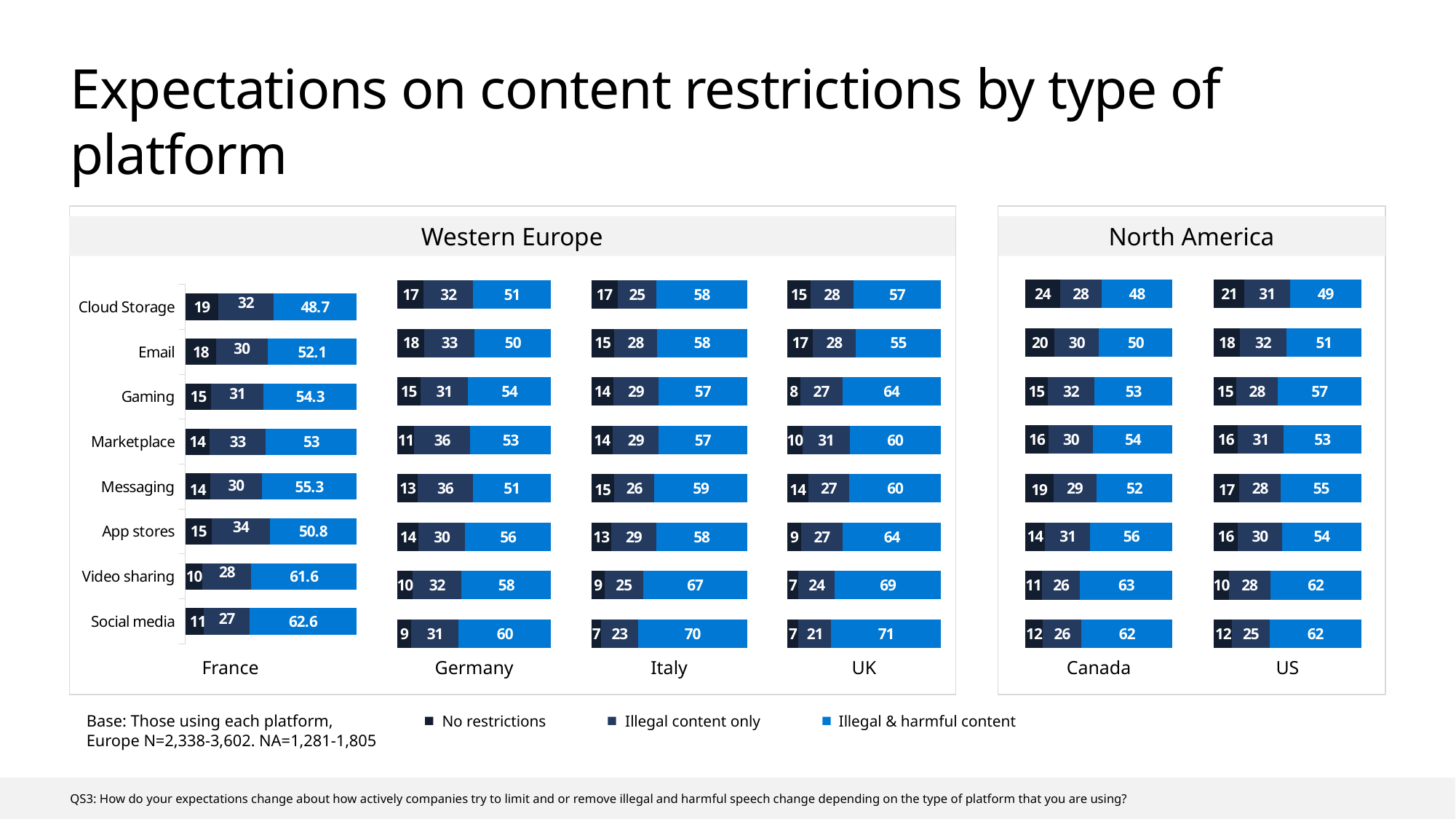
In the Germany chart, which platform has the lowest value for "No restrictions"? Social media How many platform categories are shown in the France chart? 8 Which two countries are shown under the North America heading? Canada and US In the Canada chart, what is the value for "No restrictions" for Cloud Storage? 24 In the France chart, what is the value for "Illegal & harmful content" for Social media? 62.6 In the Canada chart, what is the total of the Video sharing bar? 100 In the Italy chart, which platform has the highest value for "Illegal & harmful content"? Social media In the UK chart, what is the difference between the "Illegal & harmful content" values for Social media and Cloud Storage? 14 What kind of chart is used for each country? Stacked bar chart For Marketplace, is the "Illegal content only" value larger in the Germany chart or the Italy chart? Germany How many series does the legend list? 3 In the UK chart, what is the value for "Illegal & harmful content" for Social media? 71